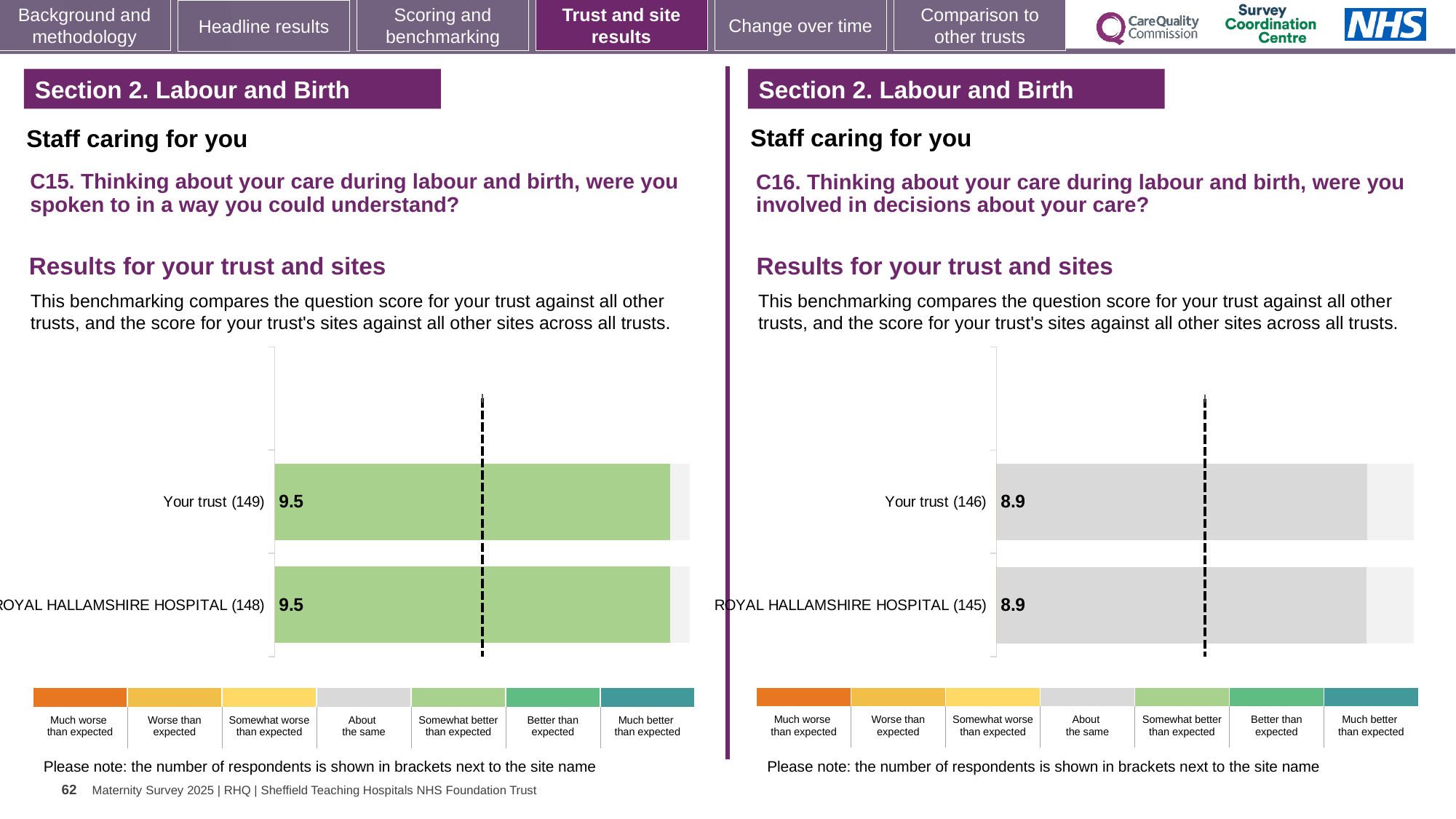
In the C16 chart on the right, what is the score for ROYAL HALLAMSHIRE HOSPITAL? 8.9 In the C15 chart on the left, what is the score for Your trust? 9.5 In the C15 chart on the left, what is the difference between the Your trust score and the ROYAL HALLAMSHIRE HOSPITAL score? 0 In the C16 chart on the right, what is the difference between the Your trust score and the ROYAL HALLAMSHIRE HOSPITAL score? 0 How many bars are plotted in the C16 chart on the right? 2 How many bars are plotted in the C15 chart on the left? 2 In the C16 chart on the right, what is the score for Your trust? 8.9 In the C15 chart on the left, what is the score for ROYAL HALLAMSHIRE HOSPITAL? 9.5 According to the colour key, which benchmark category do the bars in the C16 chart on the right fall into? About the same What kind of chart is used for the C15 results on the left? Bar chart In the C15 chart on the left, how many respondents are shown in brackets for Your trust? 149 In the C16 chart on the right, how many respondents are shown in brackets for ROYAL HALLAMSHIRE HOSPITAL? 145